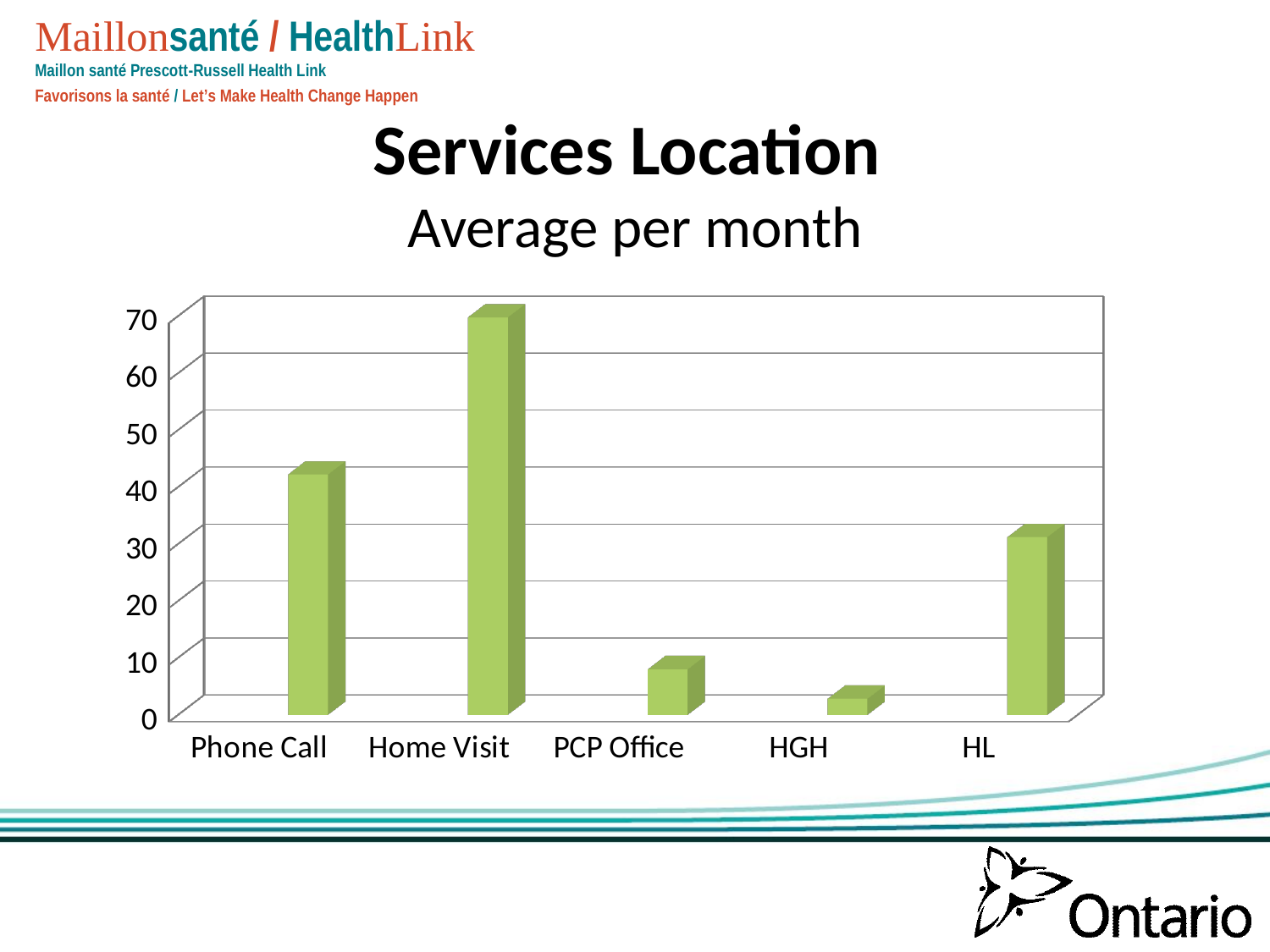
Is the value for Home Visit greater or less than 60? greater What kind of chart is shown on the slide? bar chart Is the value for HL greater or less than 20? greater What is the title of the chart on the slide? Services Location Is the value for PCP Office greater or less than 10? less How many categories are shown on the x axis of the chart? 5 Which category has the highest value in the chart? Home Visit Which is larger, the value for Phone Call or the value for HL? Phone Call Which is larger, the value for PCP Office or the value for HGH? PCP Office Which category has the lowest value in the chart? HGH